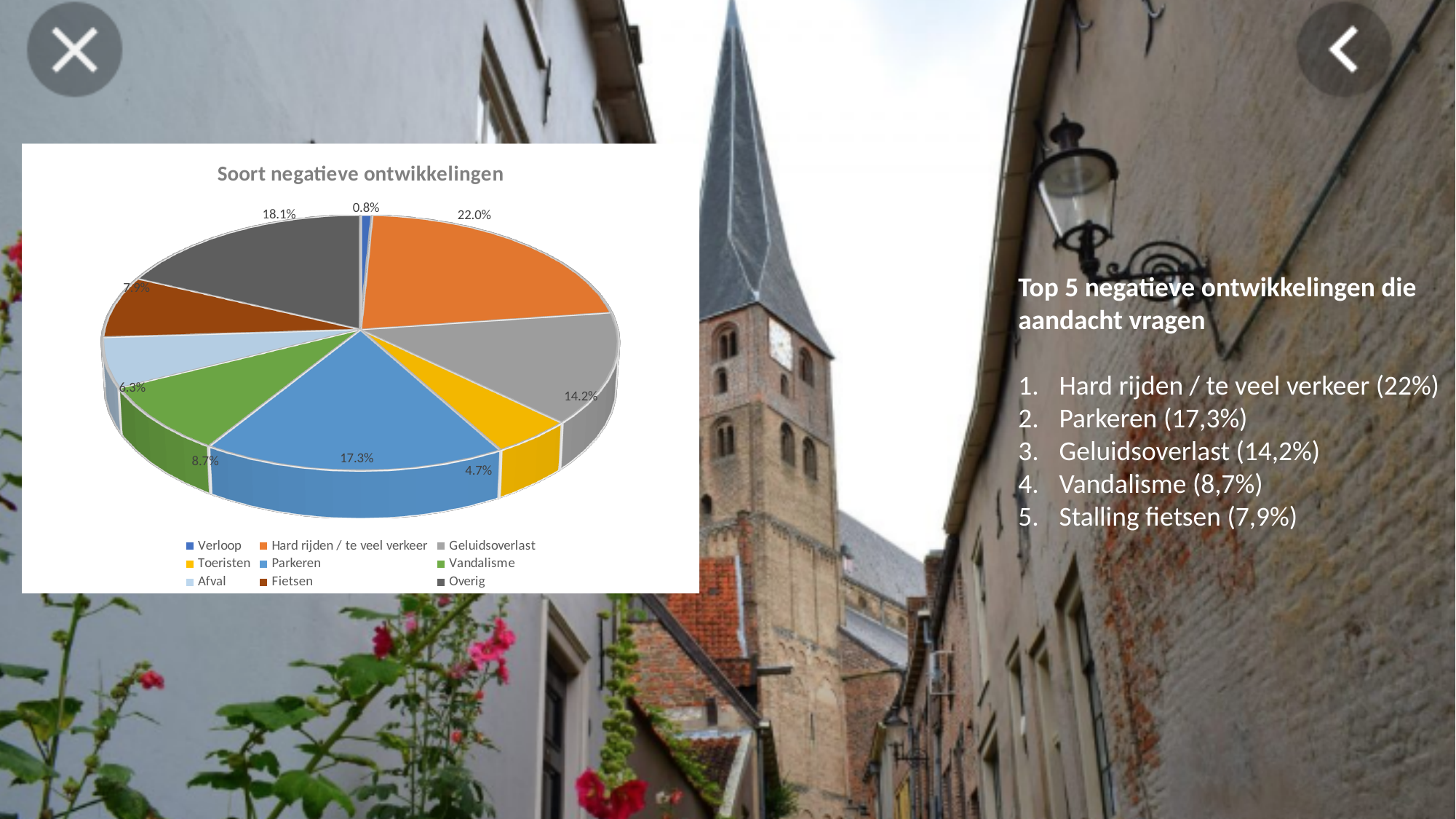
How many categories does the pie chart show? 9 Which category has the largest slice of the pie? Hard rijden / te veel verkeer What share of the pie does Hard rijden / te veel verkeer have? 22.0% Which category has the smallest slice of the pie? Verloop What percentage is shown for Parkeren? 17.3% Which is larger, the slice for Overig or the slice for Geluidsoverlast? Overig What is the title of the chart? Soort negatieve ontwikkelingen What colour is the slice for Toeristen? Yellow What percentage is shown for Vandalisme? 8.7% What kind of chart is shown on the slide? Pie chart What is the difference in percentage points between Hard rijden / te veel verkeer and Parkeren? 4.7 What percentage is shown for Geluidsoverlast? 14.2%